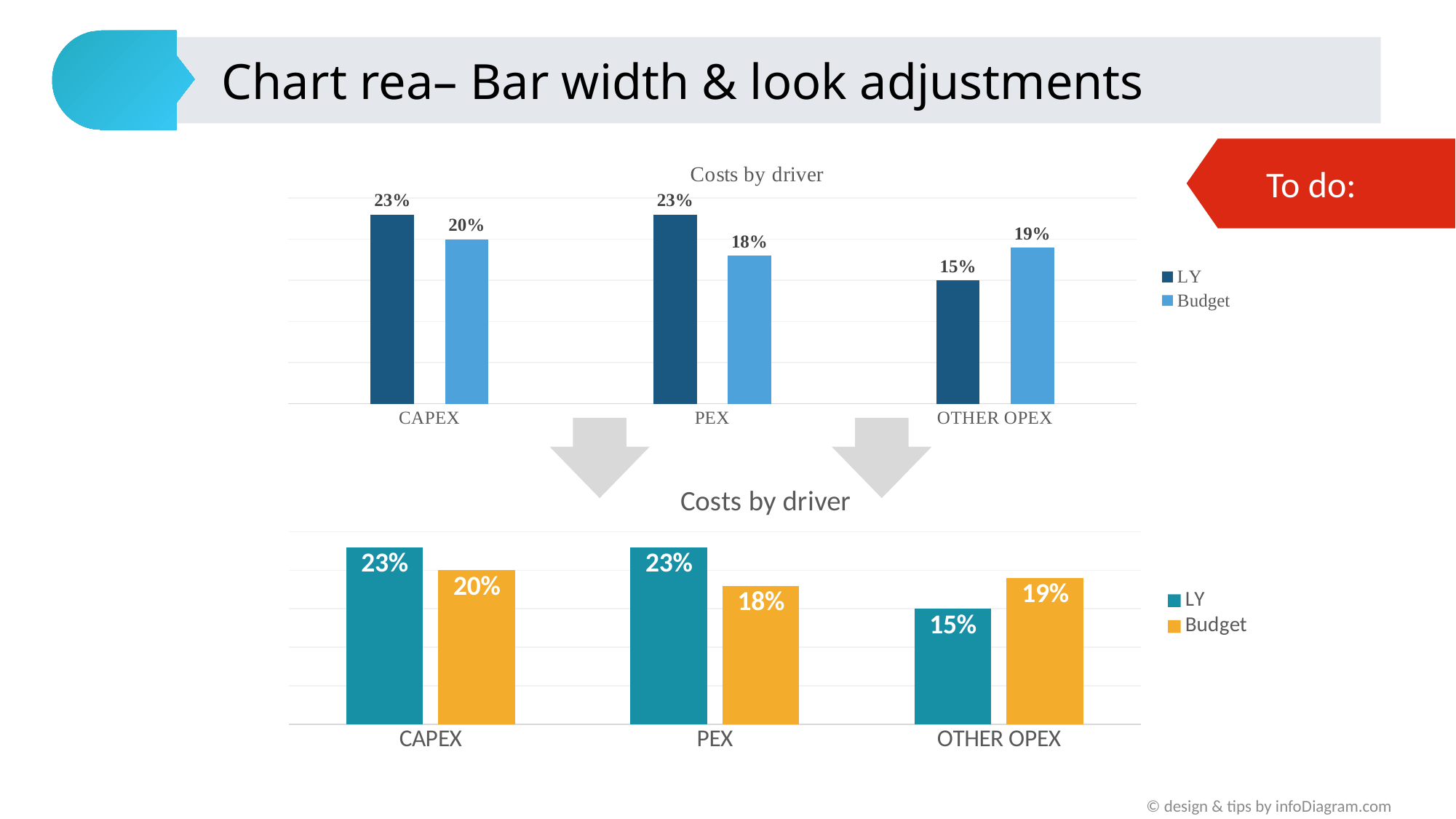
In the bottom chart, what is the Budget value for PEX? 18% In the top chart, which category has the highest Budget value? CAPEX How many series does the legend of the top chart list? 2 In the bottom chart, what is the difference between the LY and Budget values for PEX? 5% In the bottom chart, which category has the lowest LY value? OTHER OPEX In the bottom chart, which is larger for CAPEX, LY or Budget? LY In the top chart, what is the difference between the Budget and LY values for OTHER OPEX? 4% In the top chart, which is larger for OTHER OPEX, LY or Budget? Budget In the top chart, what is the Budget value for OTHER OPEX? 19% What type of chart is the bottom chart? Bar chart In the top chart, what is the LY value for CAPEX? 23% How many categories are shown on the x axis of the bottom chart? 3